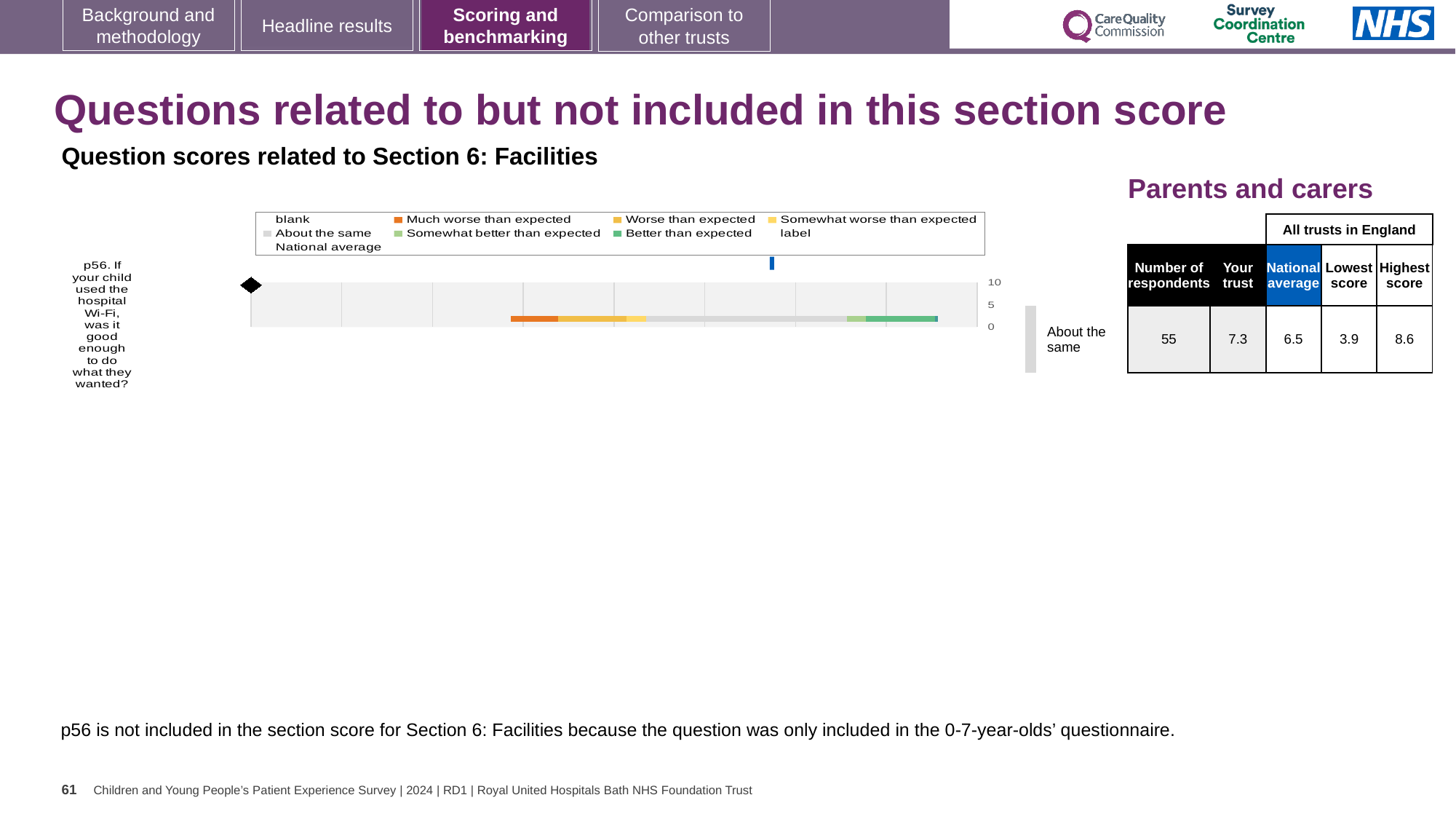
How many questions are plotted in the chart on this slide? 1 What kind of chart is used to show the p56 result on this slide? Bar chart For p56, which is higher: the 'Your trust' score or the national average? Your trust For p56, what is the difference between the highest and lowest scores among all trusts in England? 4.7 Which benchmark category is the trust's result for p56 placed in? About the same According to the table beside the chart, what is the 'Your trust' score for p56? 7.3 Which question is plotted in the chart on this slide? p56. If your child used the hospital Wi-Fi, was it good enough to do what they wanted? According to the table beside the chart, what is the lowest score among all trusts in England for p56? 3.9 According to the table beside the chart, how many respondents answered p56? 55 According to the table beside the chart, what is the highest score among all trusts in England for p56? 8.6 According to the table beside the chart, what is the national average score for p56? 6.5 For p56, what is the difference between the 'Your trust' score and the national average? 0.8